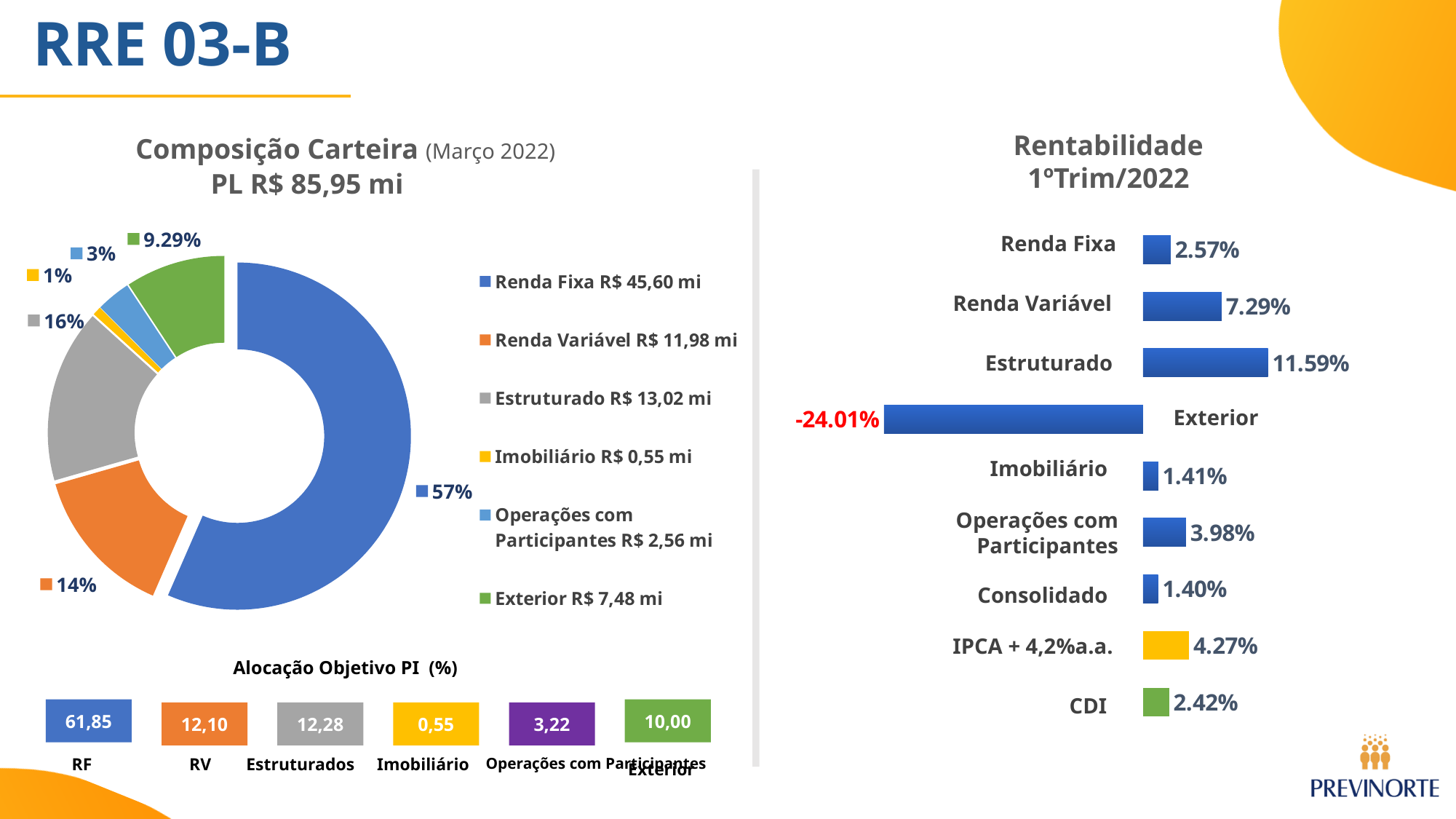
In the Rentabilidade 1ºTrim/2022 chart, which is larger: Renda Variável or CDI? Renda Variável In the Rentabilidade 1ºTrim/2022 chart, what is the value for Estruturado? 11.59% In the Composição Carteira chart, what share does Renda Fixa represent? 57% In the Alocação Objetivo PI (%) chart, what is the value for Estruturados? 12,28 In the Composição Carteira legend, what amount is shown for Renda Variável? R$ 11,98 mi How many categories are shown in the Rentabilidade 1ºTrim/2022 chart? 9 In the Rentabilidade 1ºTrim/2022 chart, what is the difference between IPCA + 4,2%a.a. and Consolidado? 2.87% In the Alocação Objetivo PI (%) chart, what is the difference between RF and RV? 49,75 How many categories are shown in the Alocação Objetivo PI (%) chart? 6 What kind of chart is the Composição Carteira chart? Donut (pie) chart In the Rentabilidade 1ºTrim/2022 chart, which category has the lowest value? Exterior In the Rentabilidade 1ºTrim/2022 chart, which category has the highest value? Estruturado